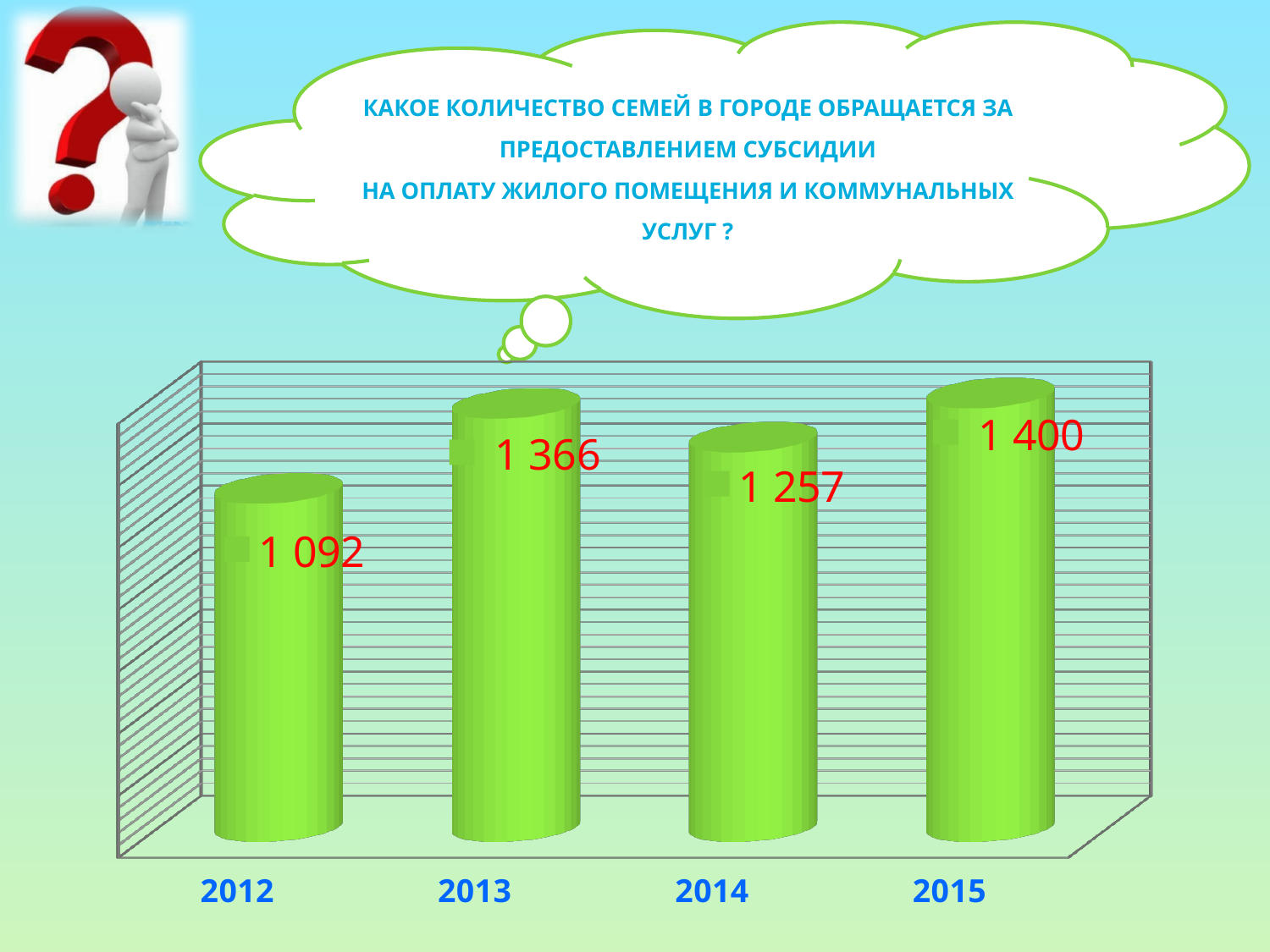
What is the difference between the values for 2015 and 2012? 308 What is the value for 2015? 1 400 What is the value for 2012? 1 092 What is the difference between the values for 2013 and 2014? 109 Which year has the highest value? 2015 What is the value for 2014? 1 257 What is the value for 2013? 1 366 How many years are shown on the chart? 4 Which is larger, the value for 2013 or the value for 2014? 2013 Which year has the lowest value? 2012 What kind of chart is shown on the slide? Bar chart What colour are the bars in the chart? Green